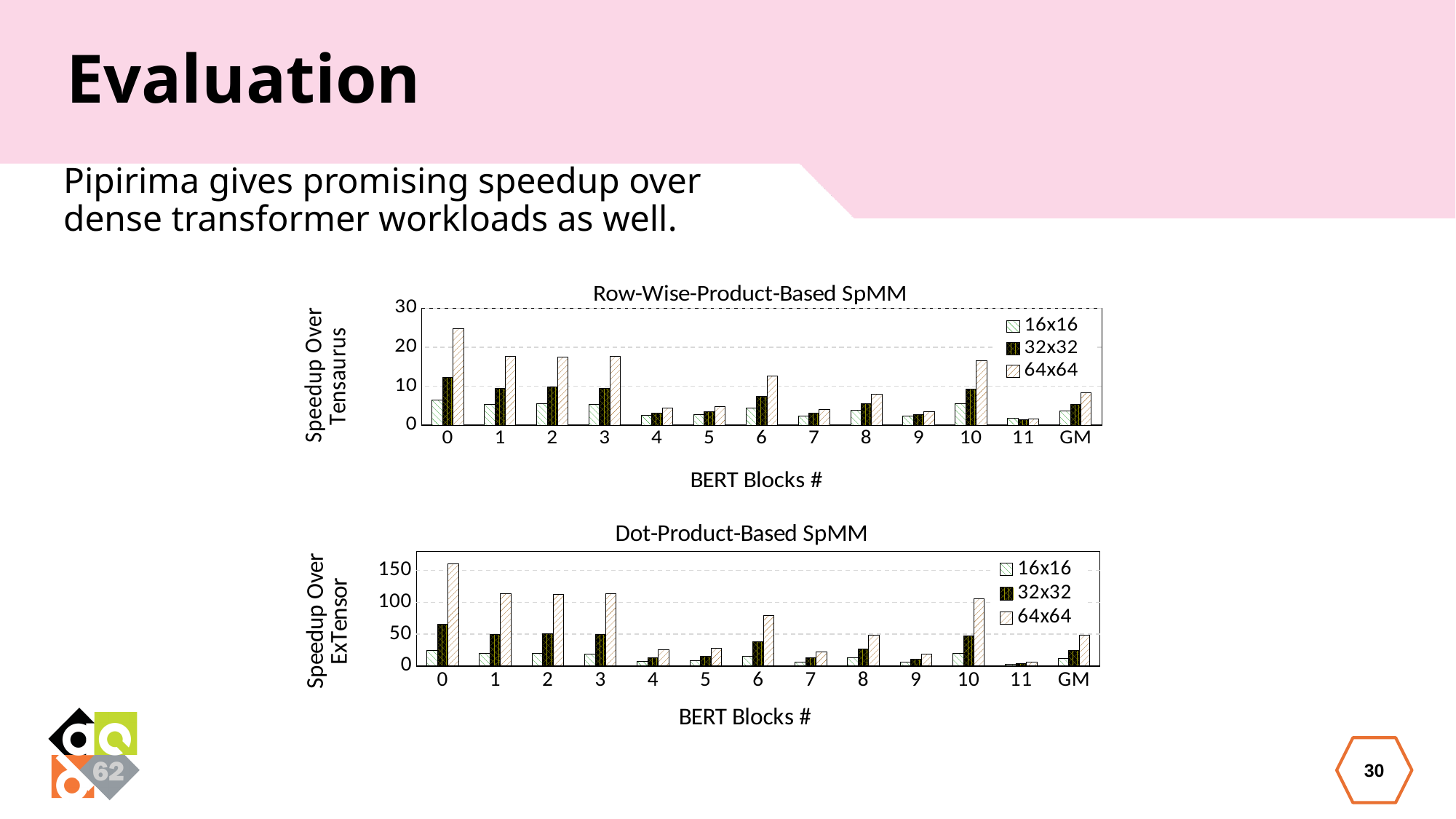
In the Dot-Product-Based SpMM chart, which BERT block has the lowest 64x64 speedup? 11 In the Row-Wise-Product-Based SpMM chart, is the 64x64 value for BERT block 0 greater or less than 20? greater In the Row-Wise-Product-Based SpMM chart, is the 64x64 value for BERT block 4 greater or less than 10? less What is the x-axis label of the Row-Wise-Product-Based SpMM chart? BERT Blocks # How many categories are shown on the x axis of the Row-Wise-Product-Based SpMM chart? 13 In the Row-Wise-Product-Based SpMM chart, which BERT block has the highest 64x64 speedup? 0 How many series does the legend of the Dot-Product-Based SpMM chart list? 3 What kind of chart is the Row-Wise-Product-Based SpMM chart? bar chart In the Dot-Product-Based SpMM chart, is the 64x64 value for BERT block 0 greater or less than 150? greater In the Dot-Product-Based SpMM chart, which is larger for BERT block 6: the 32x32 value or the 64x64 value? 64x64 What is the y-axis label of the Dot-Product-Based SpMM chart? Speedup Over ExTensor